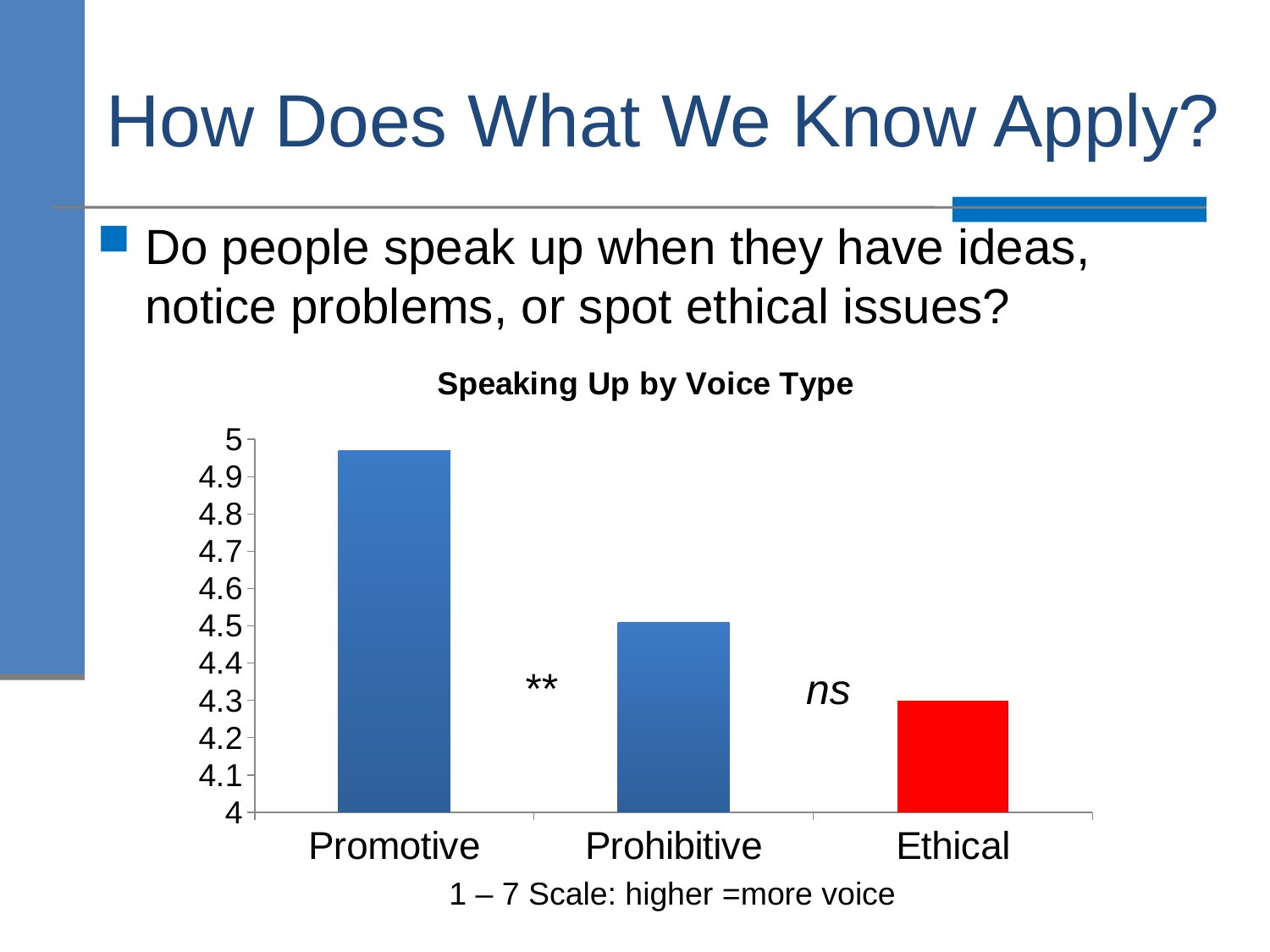
How many categories are plotted in the chart? 3 Do the values rise or fall from Promotive to Ethical along the x axis? fall Which voice type has the highest value? Promotive Is the value for Prohibitive greater or less than 4.8? less Which is larger, the value for Promotive or the value for Prohibitive? Promotive Which voice type has the lowest value? Ethical Which category's bar is coloured red? Ethical What kind of chart is shown on the slide? bar chart What is the title of the chart? Speaking Up by Voice Type Which is larger, the value for Prohibitive or the value for Ethical? Prohibitive Is the value for Promotive greater or less than 4.5? greater Is the value for Ethical greater or less than 4.5? less